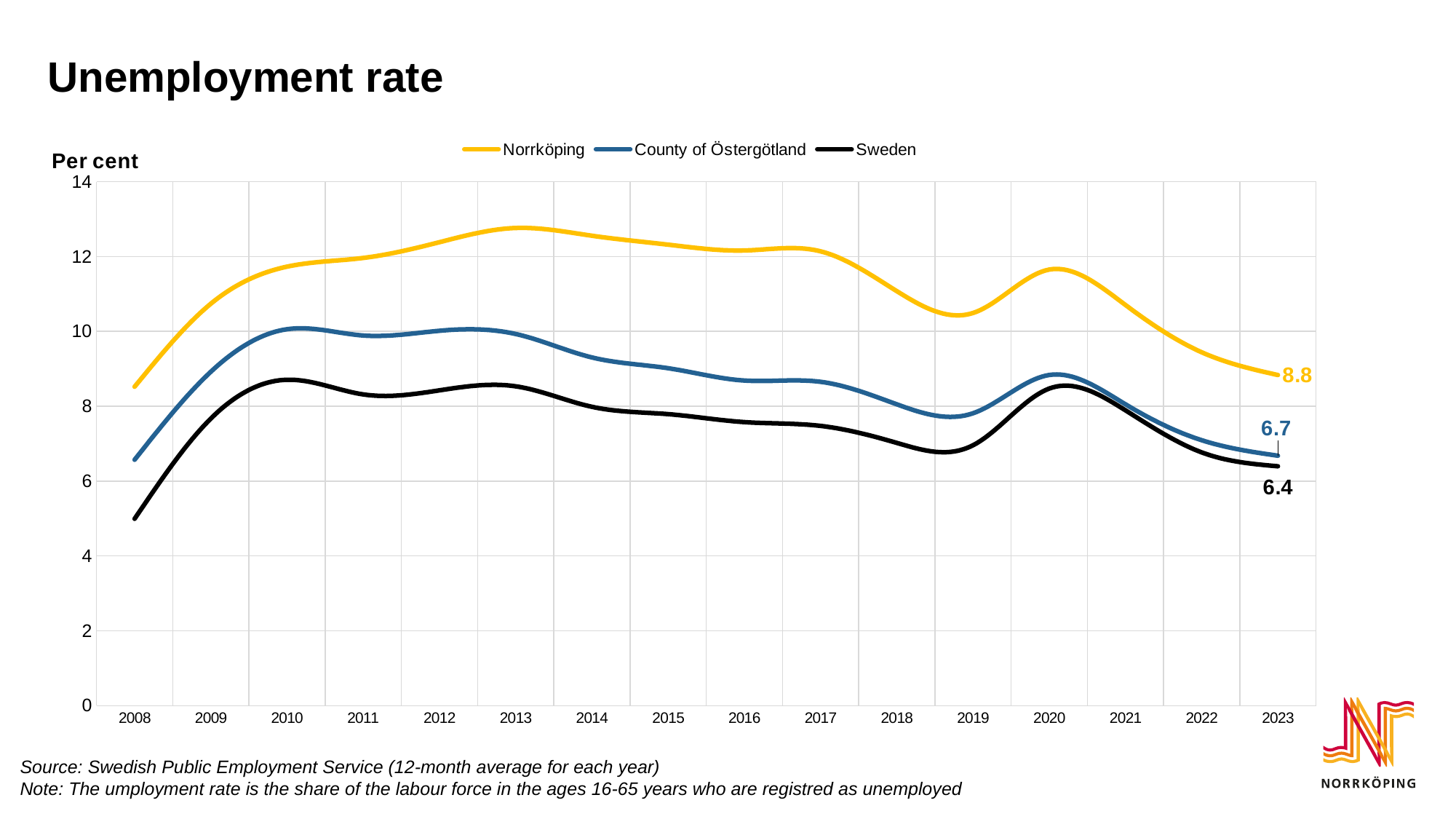
In 2023, how much higher is the unemployment rate for Norrköping than for Sweden? 2.4 How many series does the legend list? 3 Is the unemployment rate for Sweden in 2008 greater or less than 6? less Is the unemployment rate for Norrköping in 2013 greater or less than 12? greater What is the unemployment rate for Sweden in 2023? 6.4 What kind of chart is shown on the slide? line chart Does the unemployment rate for Norrköping rise or fall from 2020 to 2023? fall In 2023, what is the difference between the unemployment rate for Norrköping and for County of Östergötland? 2.1 What is the unemployment rate for Norrköping in 2023? 8.8 What is the unemployment rate for County of Östergötland in 2023? 6.7 Which series has the highest unemployment rate in 2023? Norrköping In 2023, which has the higher unemployment rate: County of Östergötland or Sweden? County of Östergötland